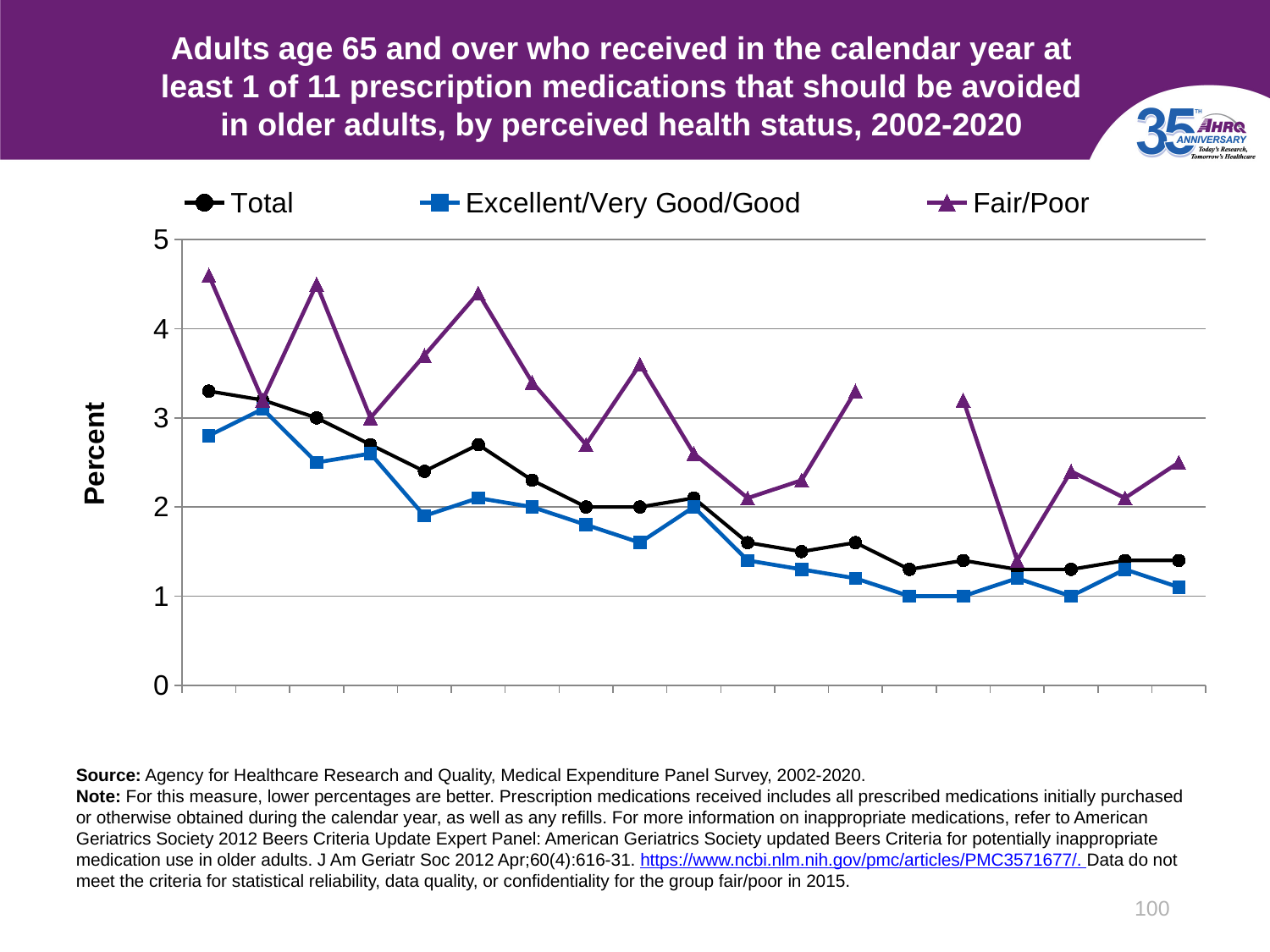
How many series does the legend list? 3 What are the three series named in the legend? Total, Excellent/Very Good/Good, Fair/Poor Is the first Fair/Poor value on the left greater or less than 4? greater Does the Total series generally rise or fall from left to right across the chart? Fall Which series has the lowest value at the first point on the left of the chart? Excellent/Very Good/Good Which series has the highest value at the first point on the left of the chart? Fair/Poor Is the last Fair/Poor value on the right greater or less than 2? greater Is the last Total value on the right greater or less than 2? less At the first point on the left, which is larger: the Total value or the Excellent/Very Good/Good value? Total Which series is plotted with triangle markers? Fair/Poor What kind of chart is shown on the slide? Line chart What is the label on the vertical axis? Percent